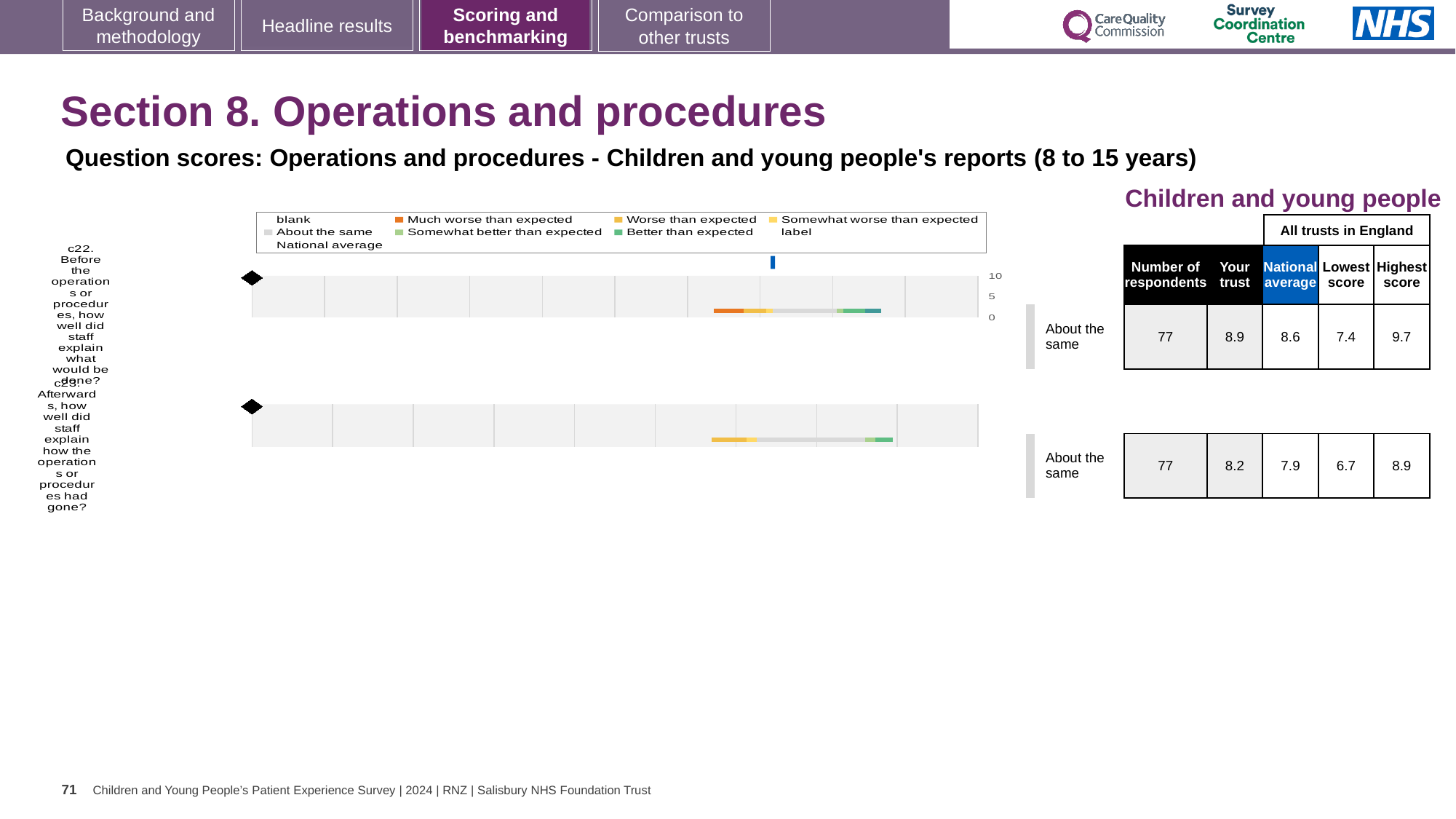
What kind of chart is used for question c22 on the slide? bar chart How many entries does the legend above the charts list? 9 Which has the higher 'Your trust' score, the c22 chart or the c23 chart? c22 For the c22 chart (before the operation, how well did staff explain what would be done), what is the 'Your trust' score shown in the table? 8.9 For the c23 chart (afterwards, how well did staff explain how the operation had gone), what is the 'Your trust' score shown in the table? 8.2 Which legend entry is shown in dark green? Better than expected For the c23 chart, what is the Highest score across all trusts in England? 8.9 For the c22 chart, what is the difference between the Highest score (9.7) and the Lowest score (7.4)? 2.3 For the c22 chart, what is the National average score shown in the table? 8.6 Which legend entry is shown in orange? Much worse than expected How many question charts (c22 and c23) are shown on the slide? 2 What benchmark category is shown next to both the c22 and c23 charts? About the same